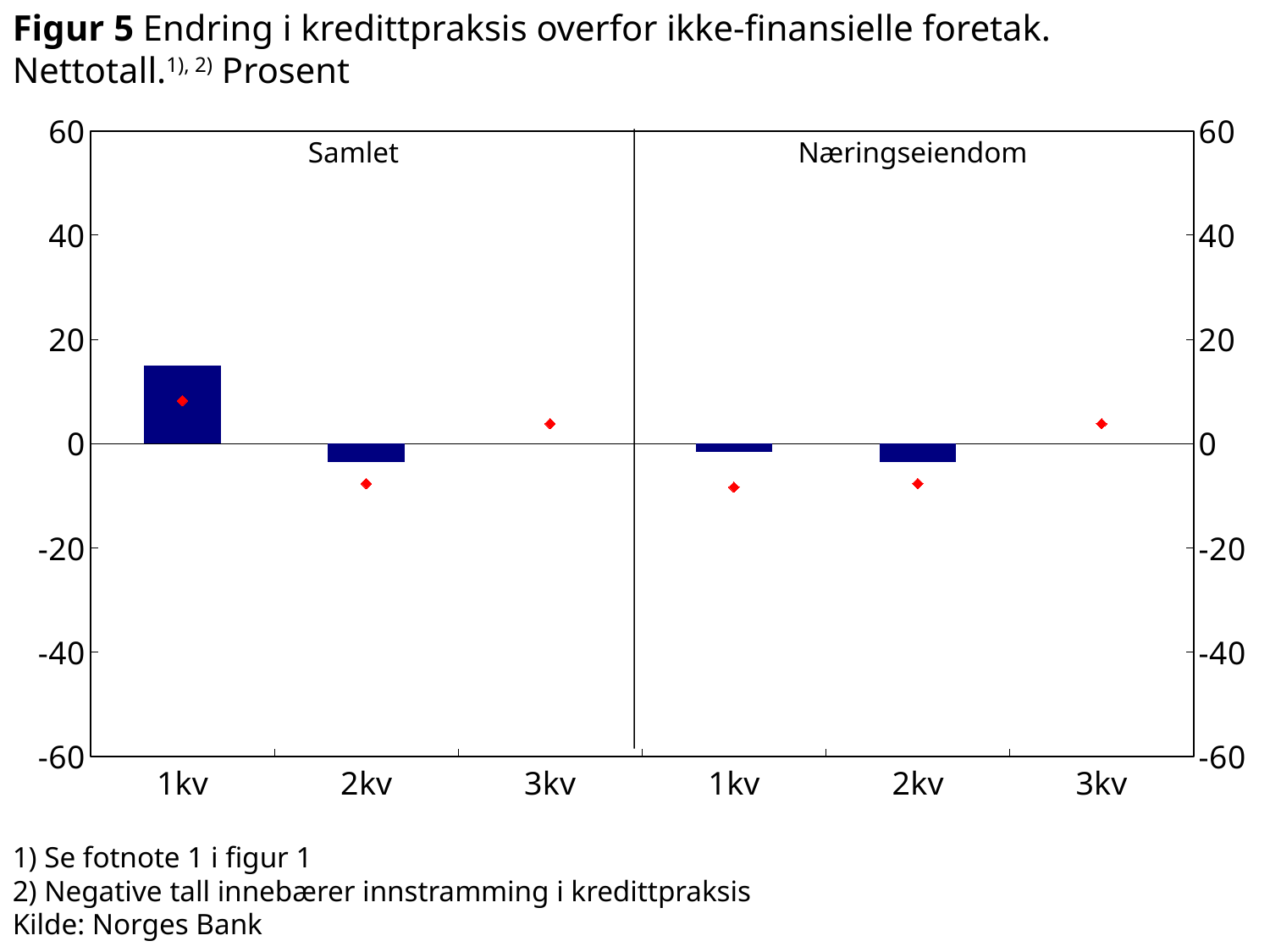
Which is larger: the Samlet bar for 1kv or the Samlet bar for 2kv? Samlet 1kv How many quarters are shown on the x axis of the Samlet panel? 3 In the Samlet panel, is the bar for 1kv greater or less than 0? greater What kind of chart is shown on the slide? combination bar and line chart (bars with red diamond markers) In the Næringseiendom panel, is the bar for 2kv greater or less than 0? less What are the titles of the two panels in the chart? Samlet and Næringseiendom In the Samlet panel, which quarter has the highest bar? 1kv In the Samlet panel, is the bar for 2kv greater or less than 0? less What source is given for the chart? Norges Bank Which is larger: the 1kv bar in the Samlet panel or the 1kv bar in the Næringseiendom panel? Samlet 1kv